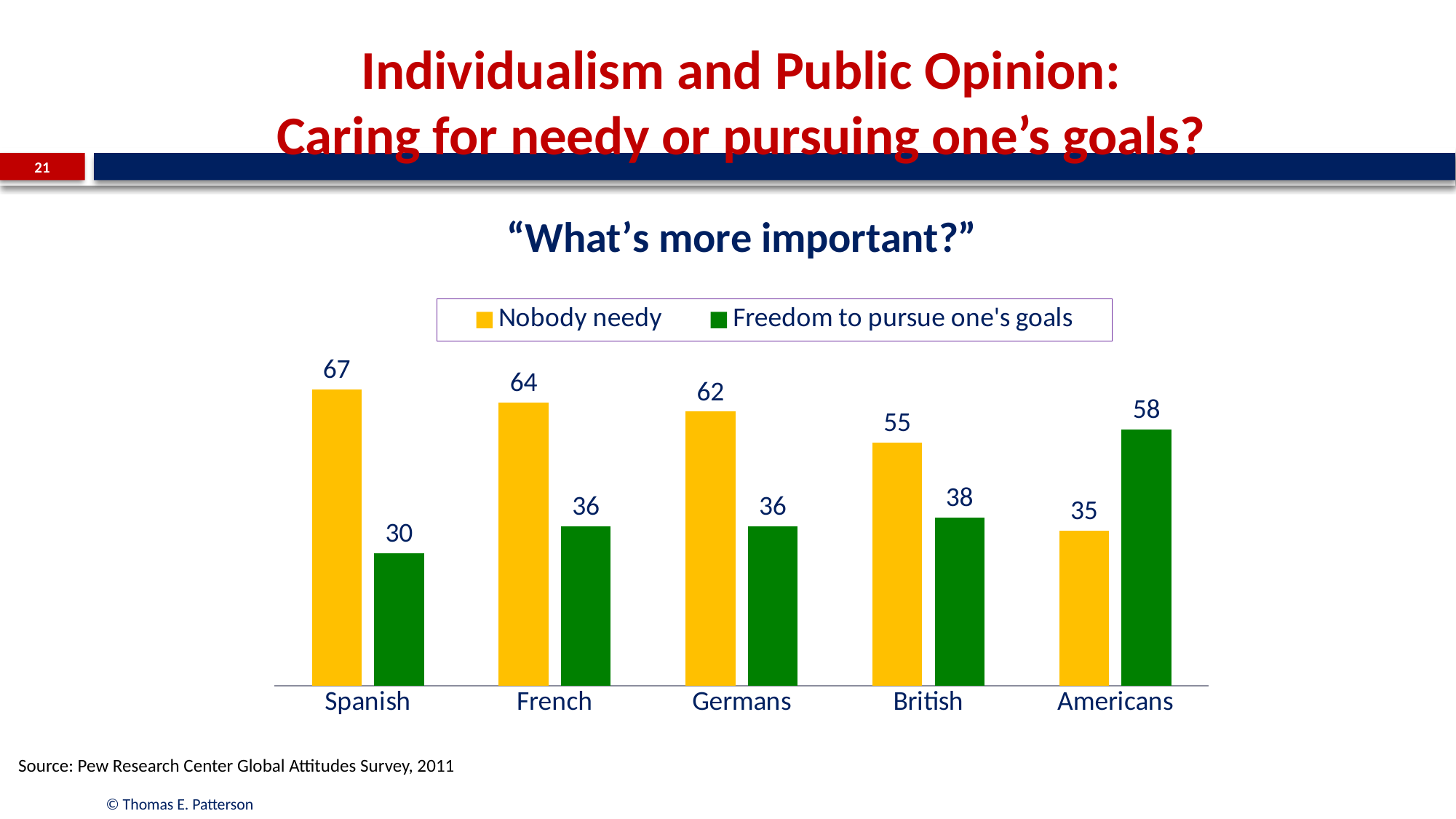
What kind of chart is shown on the slide? Bar chart Which group has the lowest value for "Freedom to pursue one's goals"? Spanish Which group has the highest value for "Nobody needy"? Spanish What colour represents the "Freedom to pursue one's goals" series? Green What is the value for "Freedom to pursue one's goals" for the British? 38 How many series does the legend list? 2 What is the value for "Nobody needy" for the Spanish? 67 For Americans, which is larger: "Nobody needy" or "Freedom to pursue one's goals"? Freedom to pursue one's goals How many groups are shown on the x axis? 5 Do the "Nobody needy" values rise or fall from Spanish to Americans along the x axis? Fall What is the difference between the "Nobody needy" and "Freedom to pursue one's goals" values for the French? 28 What is the value for "Freedom to pursue one's goals" for Americans? 58